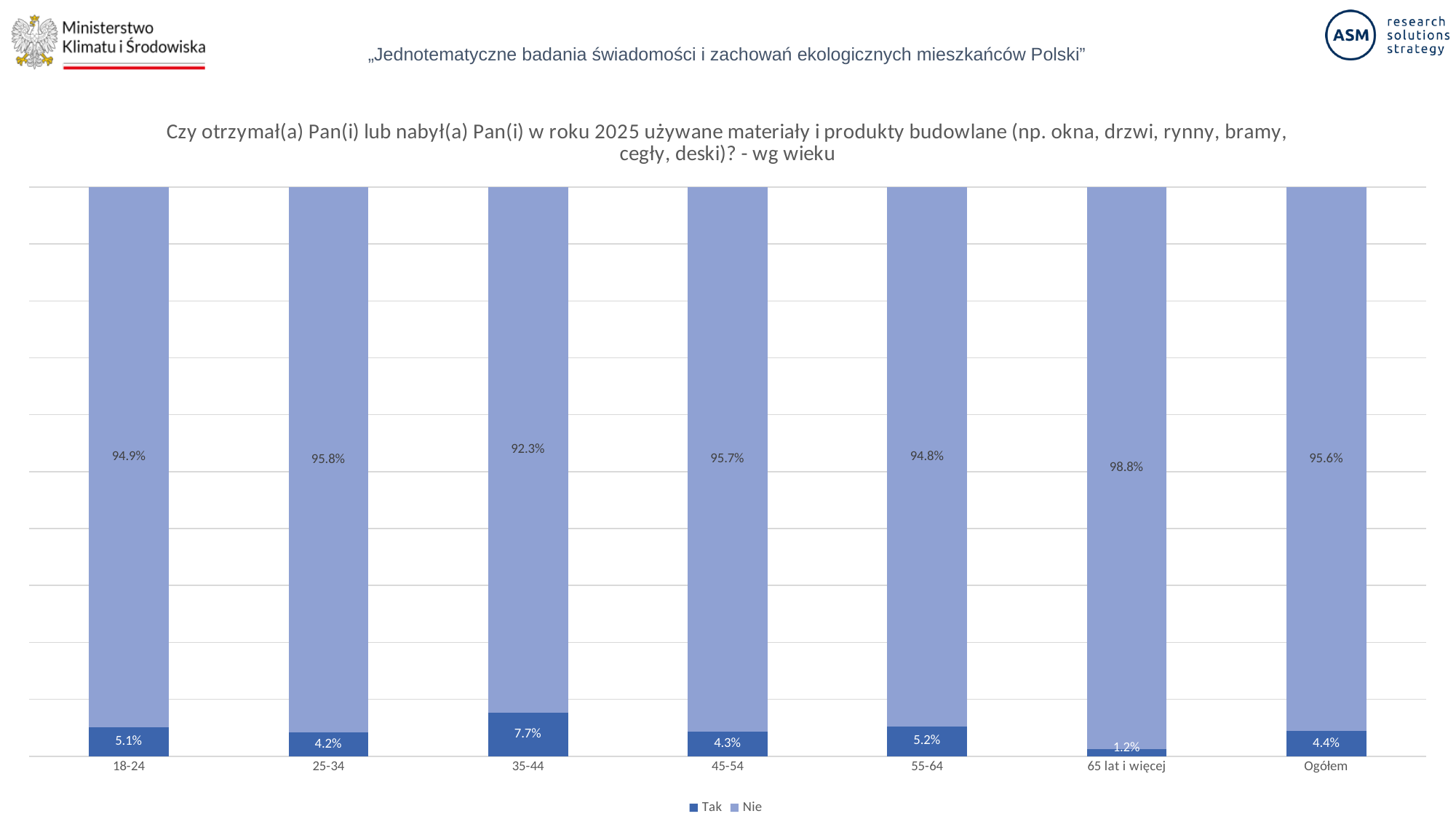
What is the value for "Tak" in the 35-44 age group? 7.7% How many series does the legend list? 2 Which age group has the lowest value for "Tak"? 65 lat i więcej What is the total of the stacked bar for the 55-64 age group? 100% How many categories are shown on the x axis? 7 What is the value for "Tak" in the Ogółem category? 4.4% Which is larger: the "Nie" value for 25-34 or for 35-44? 25-34 What are the two series listed in the legend? Tak and Nie What is the difference between the "Tak" values for the 35-44 and 18-24 age groups? 2.6% Which age group has the highest value for "Tak"? 35-44 What is the value for "Nie" in the 65 lat i więcej age group? 98.8% What kind of chart is shown on the slide? Stacked bar chart